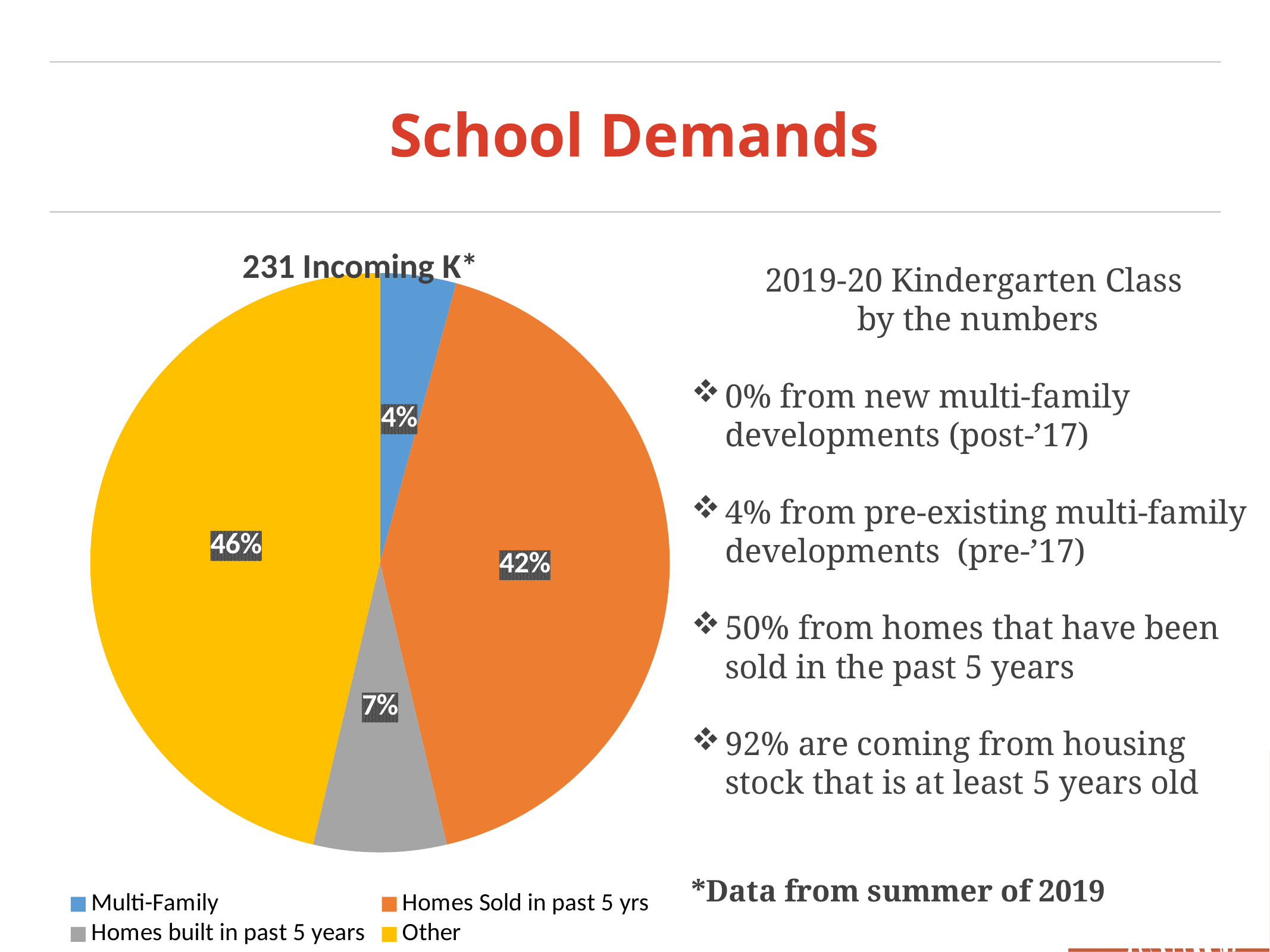
What colour is the Other slice of the pie? yellow What share of the pie is labelled for Homes Sold in past 5 yrs? 42% Which category has the largest slice of the pie? Other Which is larger, the Homes built in past 5 years slice or the Multi-Family slice? Homes built in past 5 years What type of chart is shown on the slide? pie chart What is the chart's title? 231 Incoming K* What share of the pie is labelled for Homes built in past 5 years? 7% What is the difference in percentage points between the Other slice and the Homes Sold in past 5 yrs slice? 4 What share of the pie is labelled for Other? 46% Which category has the smallest slice of the pie? Multi-Family How many categories does the legend list? 4